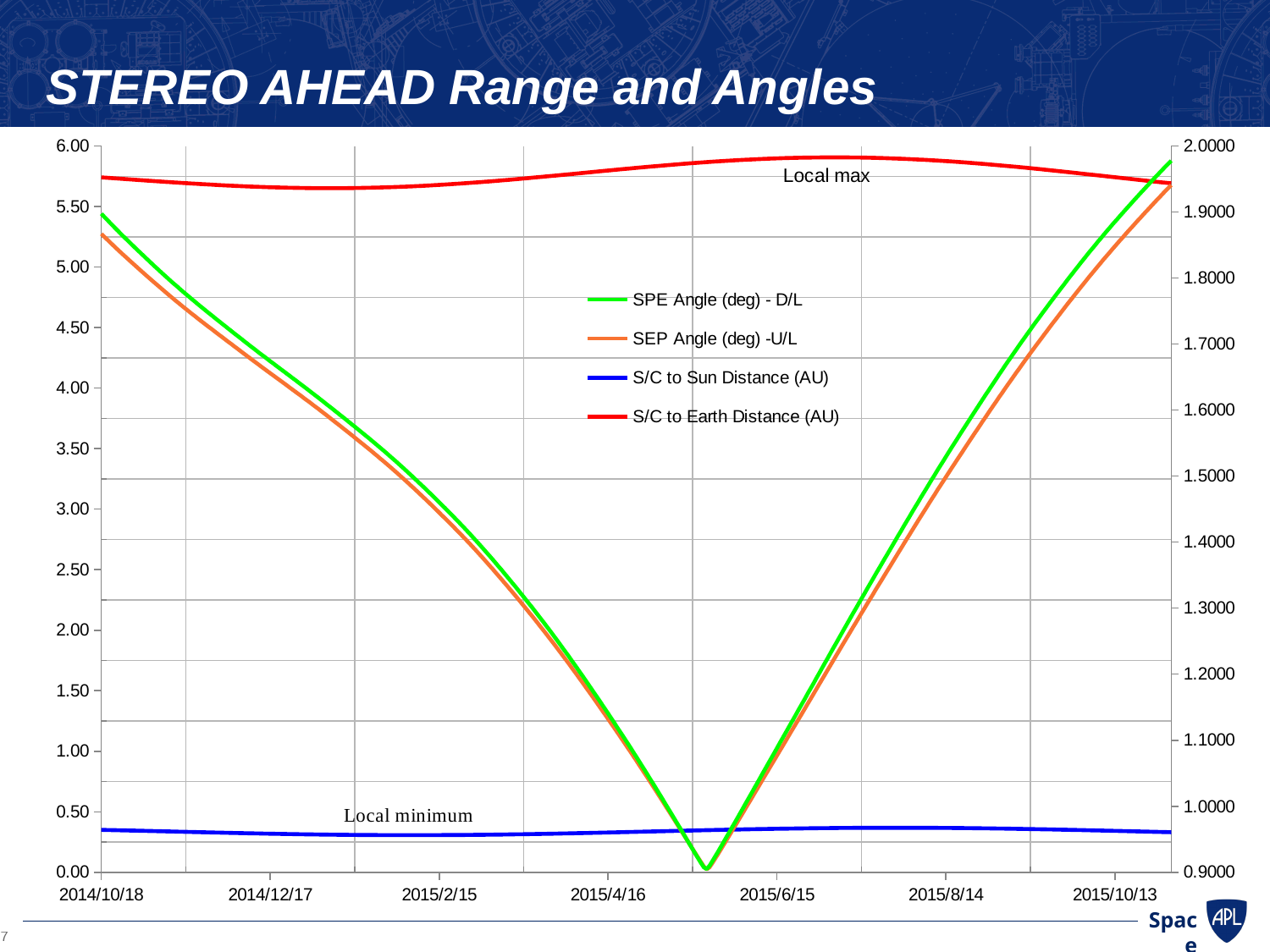
At 2014/10/18, which is higher: SPE Angle (deg) - D/L or SEP Angle (deg) -U/L? SPE Angle (deg) - D/L How many series does the legend list? 4 Which series is drawn in red? S/C to Earth Distance (AU) What is the title of the chart? STEREO AHEAD Range and Angles Does the SPE Angle (deg) - D/L series rise or fall between 2014/10/18 and 2015/4/16? fall How many date labels are shown on the x axis? 7 Does the SEP Angle (deg) -U/L series rise or fall between 2015/6/15 and 2015/10/13? rise What kind of chart is shown on the slide? line chart Is the value of SPE Angle (deg) - D/L at 2015/8/14 greater or less than 3.00? greater Is the S/C to Sun Distance (AU) at 2015/6/15 greater or less than 1.0000 on the right axis? less Is the value of SPE Angle (deg) - D/L at 2014/10/18 greater or less than 5.00? greater